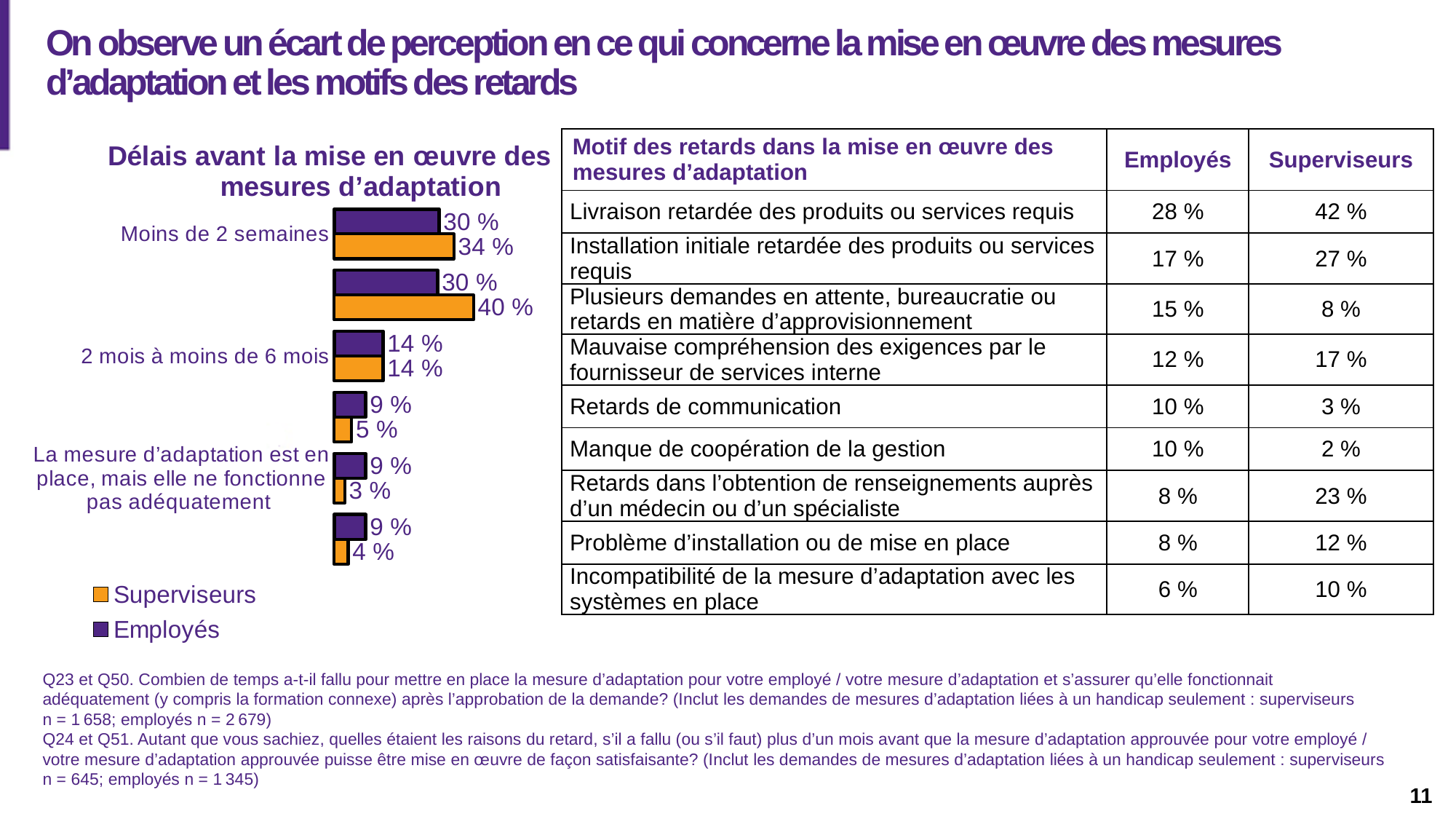
How many series does the chart's legend list? 2 In the chart, what is the Superviseurs value for 'Moins de 2 semaines'? 34 % Which series is shown in orange in the chart? Superviseurs In the chart, what is the Superviseurs value for '2 mois à moins de 6 mois'? 14 % In the chart, which series has the larger value for 'La mesure d'adaptation est en place, mais elle ne fonctionne pas adéquatement', Employés or Superviseurs? Employés In the chart, what is the difference between the Superviseurs and Employés values for 'Moins de 2 semaines'? 4 % What kind of chart is shown on the left of the slide? bar chart In the chart, what is the Employés value for 'La mesure d'adaptation est en place, mais elle ne fonctionne pas adéquatement'? 9 % What is the highest Superviseurs value shown in the chart? 40 % What is the title of the chart on the slide? Délais avant la mise en œuvre des mesures d'adaptation In the chart, what is the Superviseurs value for 'La mesure d'adaptation est en place, mais elle ne fonctionne pas adéquatement'? 3 % In the chart, what is the Employés value for 'Moins de 2 semaines'? 30 %